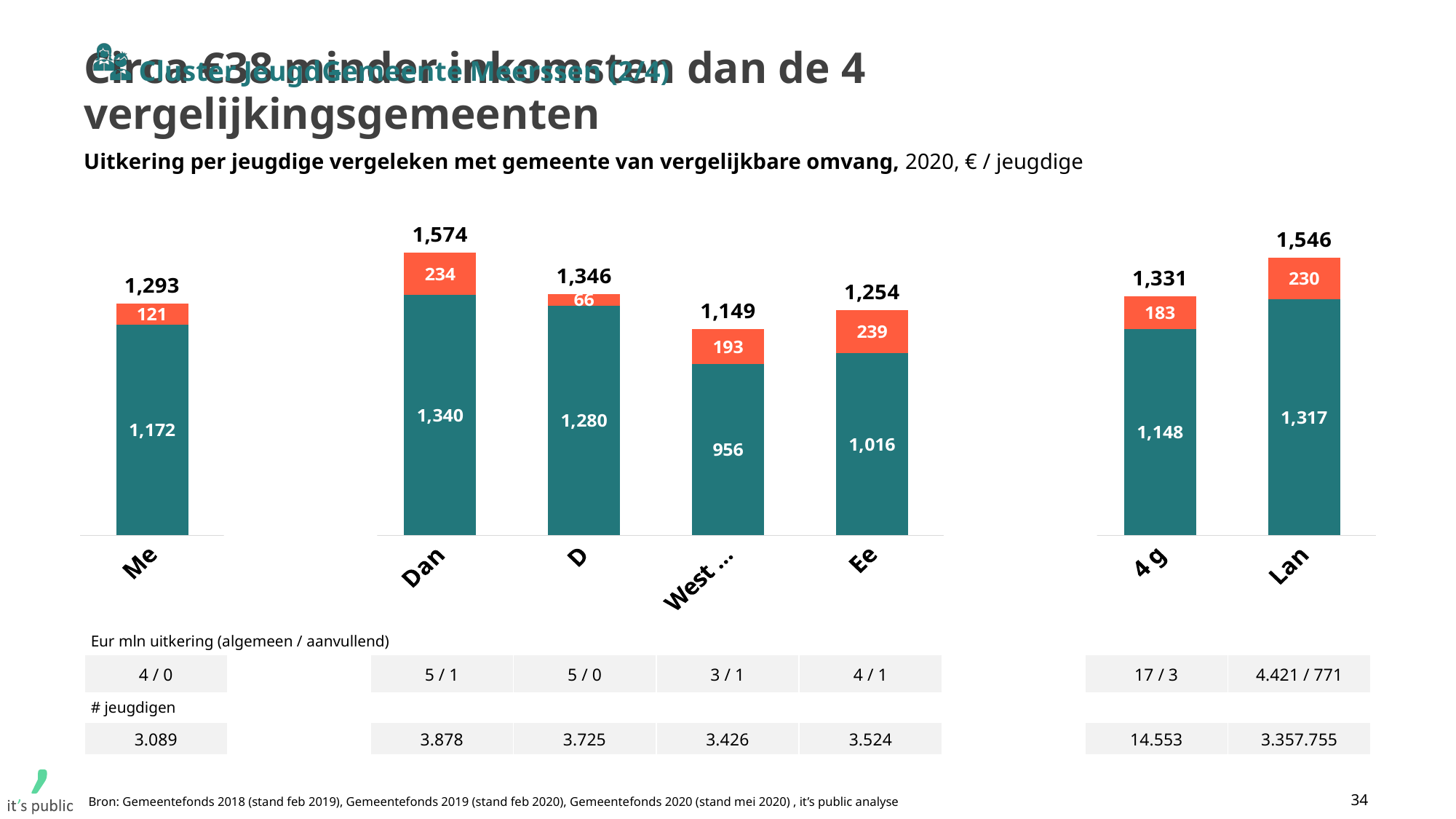
What is the total value shown above the bar for Me? 1,293 Which has a larger total value, Lan or 4 g? Lan How many bars are shown in the chart? 7 What is the total of the stacked bar for 4 g? 1,331 What type of chart is shown on the slide? Stacked bar chart What is the difference between the total for Dan and the total for Me? 281 What is the value of the teal (lower) segment of the Dan bar? 1,340 What is the value of the orange (upper) segment of the D bar? 66 What is the value of the teal (lower) segment of the Lan bar? 1,317 Which category has the smallest orange (upper) segment? D Which category has the highest total value? Dan What is the value of the orange (upper) segment of the Ee bar? 239